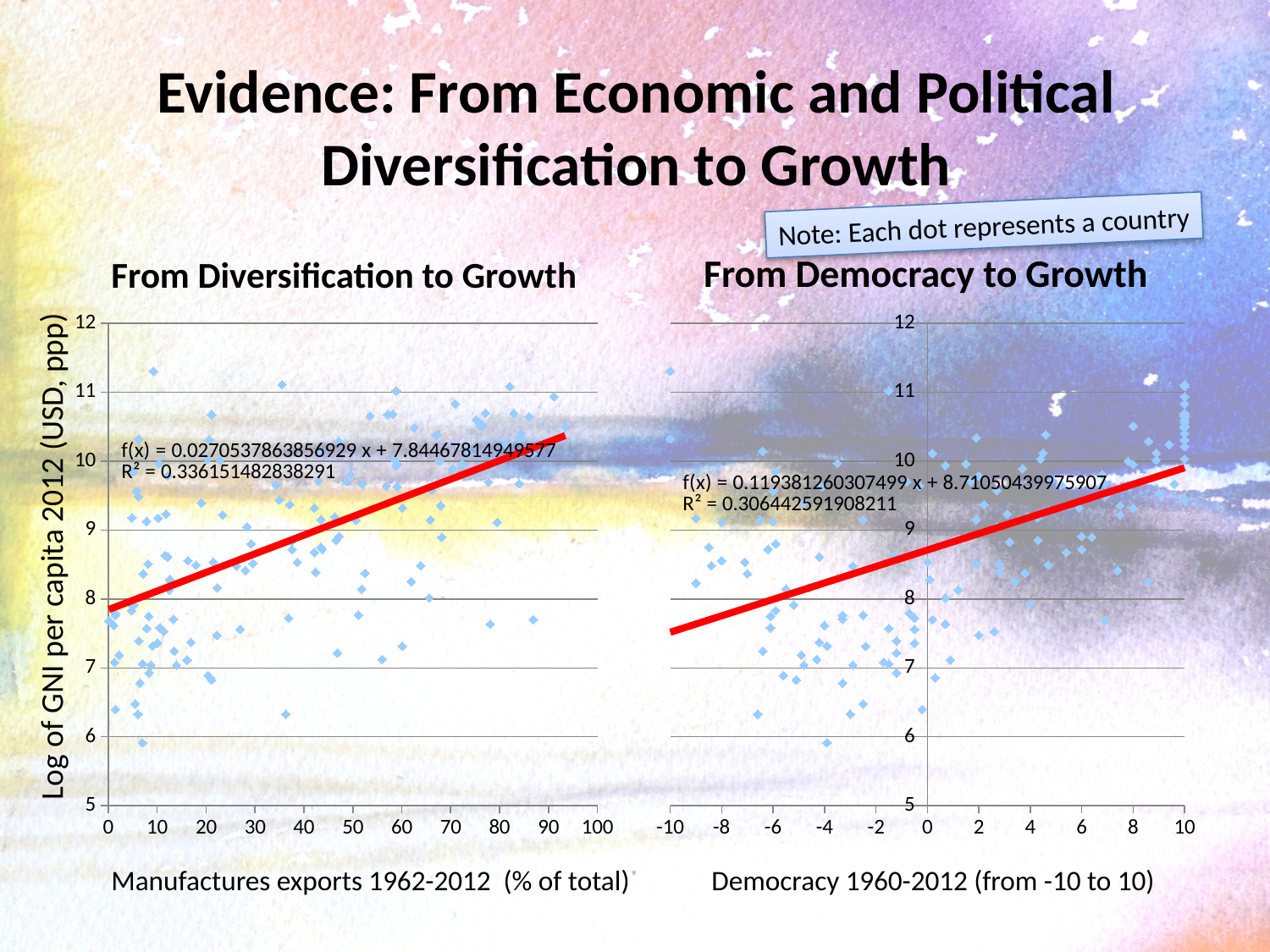
What is the x-axis label of the 'From Democracy to Growth' chart? Democracy 1960-2012 (from -10 to 10) What is the R² value printed on the 'From Democracy to Growth' chart? 0.306442591908211 What kind of chart is the 'From Diversification to Growth' chart? scatter chart What is the y-axis label shared by the two charts? Log of GNI per capita 2012 (USD, ppp) What is the R² value printed on the 'From Diversification to Growth' chart? 0.336151482838291 Which chart's trend line has the steeper slope, 'From Diversification to Growth' or 'From Democracy to Growth'? From Democracy to Growth What is the slope of the trend line equation printed on the 'From Diversification to Growth' chart? 0.0270537863856929 In the 'From Diversification to Growth' chart, does the red trend line rise or fall as manufactures exports increase along the x axis? rise Which chart has the higher R² value, 'From Diversification to Growth' or 'From Democracy to Growth'? From Diversification to Growth What is the intercept of the trend line equation printed on the 'From Democracy to Growth' chart? 8.71050439975907 How many charts are shown on the slide? 2 In the 'From Democracy to Growth' chart, does the red trend line rise or fall as democracy increases along the x axis? rise